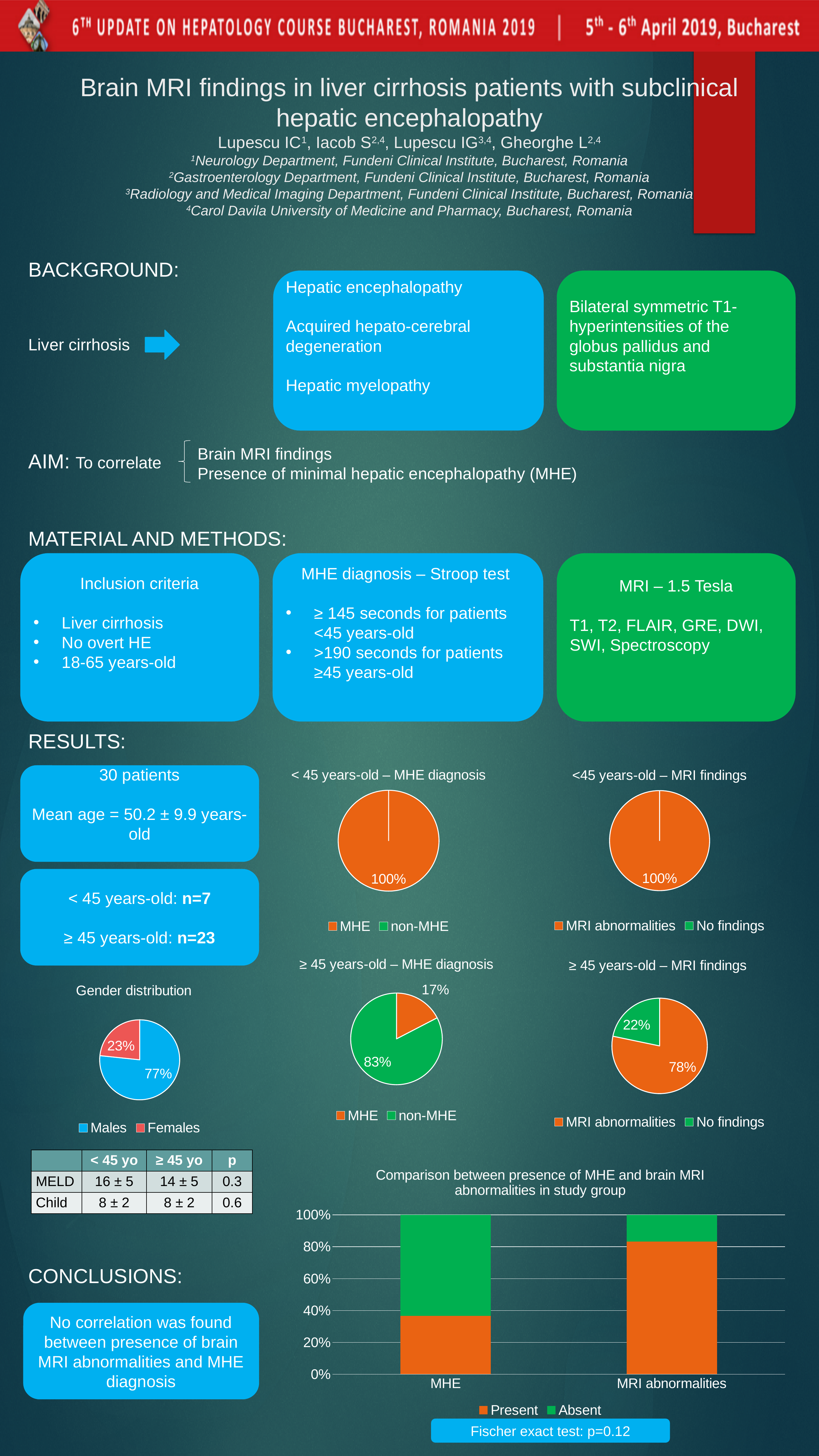
In the '<45 years-old – MRI findings' pie chart, which category is largest? MRI abnormalities In the '≥ 45 years-old – MHE diagnosis' pie chart, what percentage is labelled for MHE? 17% In the '≥ 45 years-old – MRI findings' pie chart, what is the difference between the MRI abnormalities share and the No findings share? 56% In the Gender distribution pie chart, what share of patients are Males? 77% In the 'Comparison between presence of MHE and brain MRI abnormalities in study group' chart, how many series does the legend list? 2 In the Gender distribution pie chart, which slice is larger, Males or Females? Males In the '≥ 45 years-old – MHE diagnosis' pie chart, what percentage is labelled for non-MHE? 83% What kind of chart is 'Comparison between presence of MHE and brain MRI abnormalities in study group'? bar chart In the Gender distribution pie chart, what share of patients are Females? 23% In the '≥ 45 years-old – MRI findings' pie chart, what percentage is labelled for MRI abnormalities? 78% In the 'Comparison between presence of MHE and brain MRI abnormalities in study group' chart, is the Present value for MRI abnormalities greater or less than 60%? greater In the '< 45 years-old – MHE diagnosis' pie chart, what percentage is shown for MHE? 100%